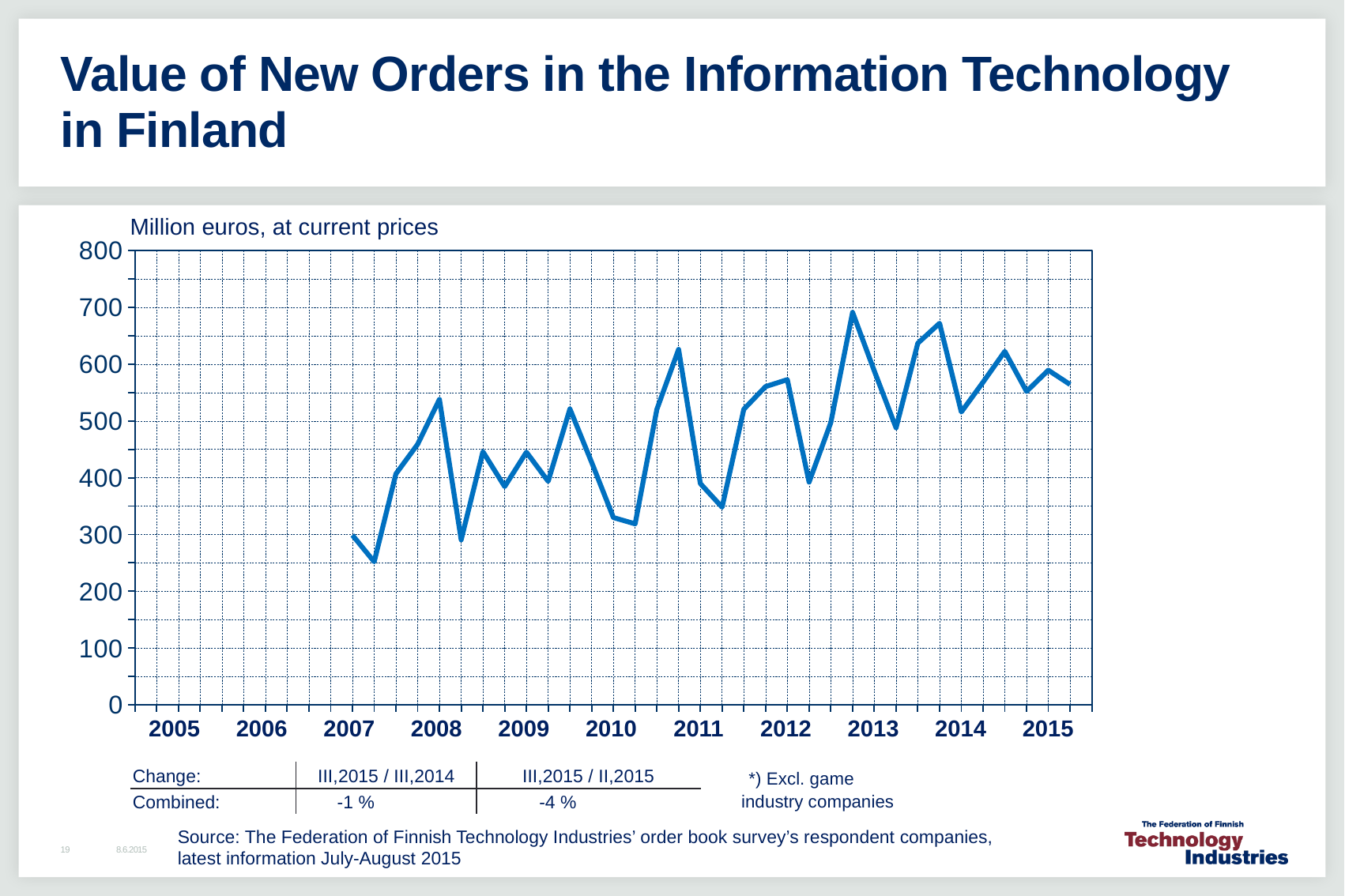
Which is higher, the first plotted point in 2007 or the last plotted point in 2015? 2015 Is the peak reached in 2008 higher or lower than the peak reached around 2013? lower How many year labels are shown on the x axis of the chart? 11 Is the lowest value in 2011 greater or less than 400? less In which year does the line reach its lowest value? 2007 Is the lowest point of the line greater or less than 300? less What unit is stated above the y axis of the chart? Million euros, at current prices According to the change table below the chart, what is the combined change for III,2015 / II,2015? -4 % Is the highest point of the line greater or less than 600? greater What kind of chart is shown on the slide? line chart Overall, does the value of new orders rise or fall from 2007 to 2015? rise